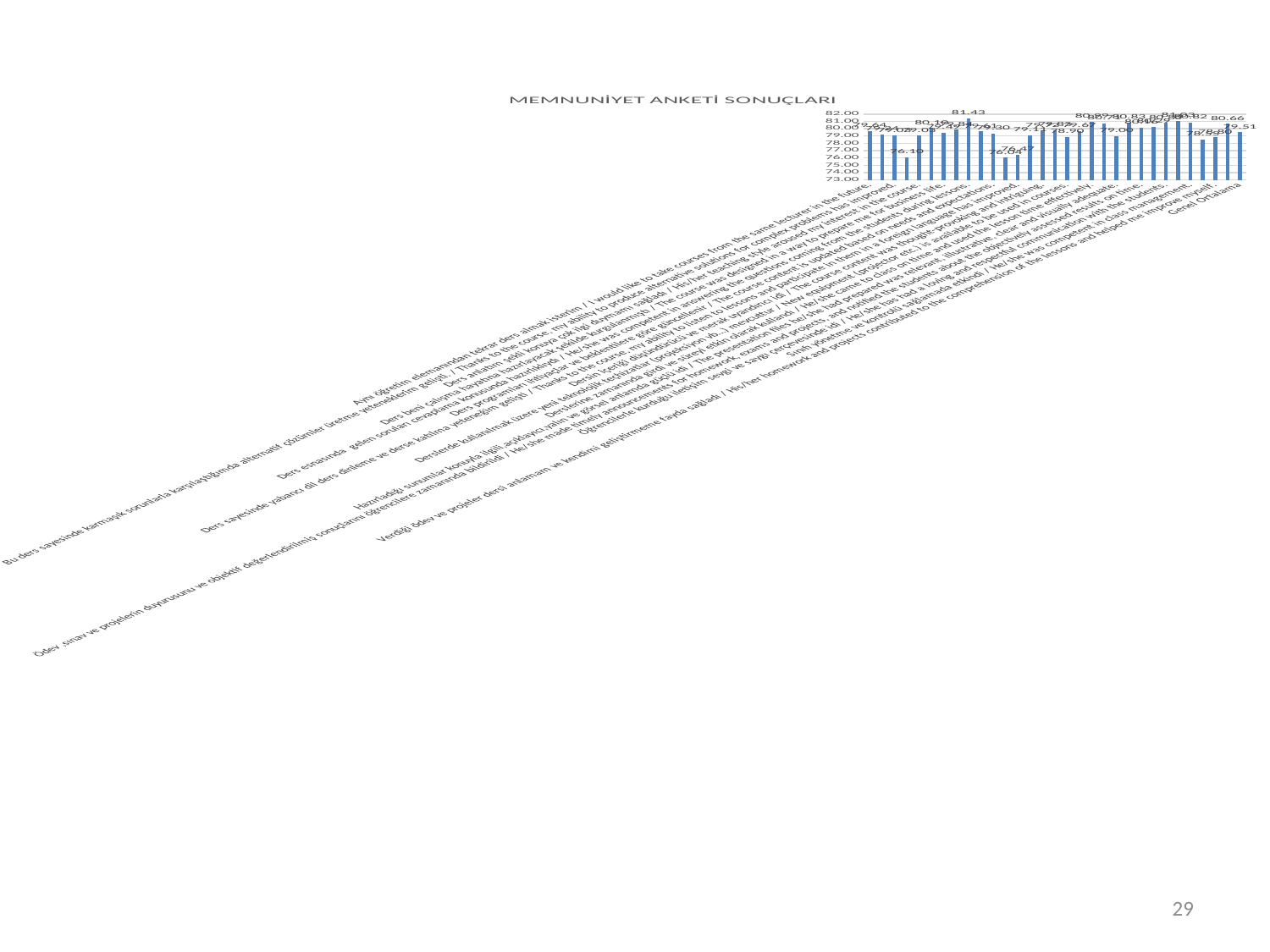
Which is larger: the highest value in the chart (81.43) or the Genel Ortalama value (79.51)? 81.43 What is the highest value shown in the chart? 81.43 Is the value for Genel Ortalama greater or less than 78.00? greater Is the highest bar in the chart greater or less than 81.00? greater What is the difference between the highest value (81.43) and the Genel Ortalama value (79.51)? 1.92 What kind of chart is shown on the slide? bar chart What is the lowest value shown on the vertical axis? 73.00 What is the value for Genel Ortalama? 79.51 What is the title of the chart? MEMNUNİYET ANKETİ SONUÇLARI